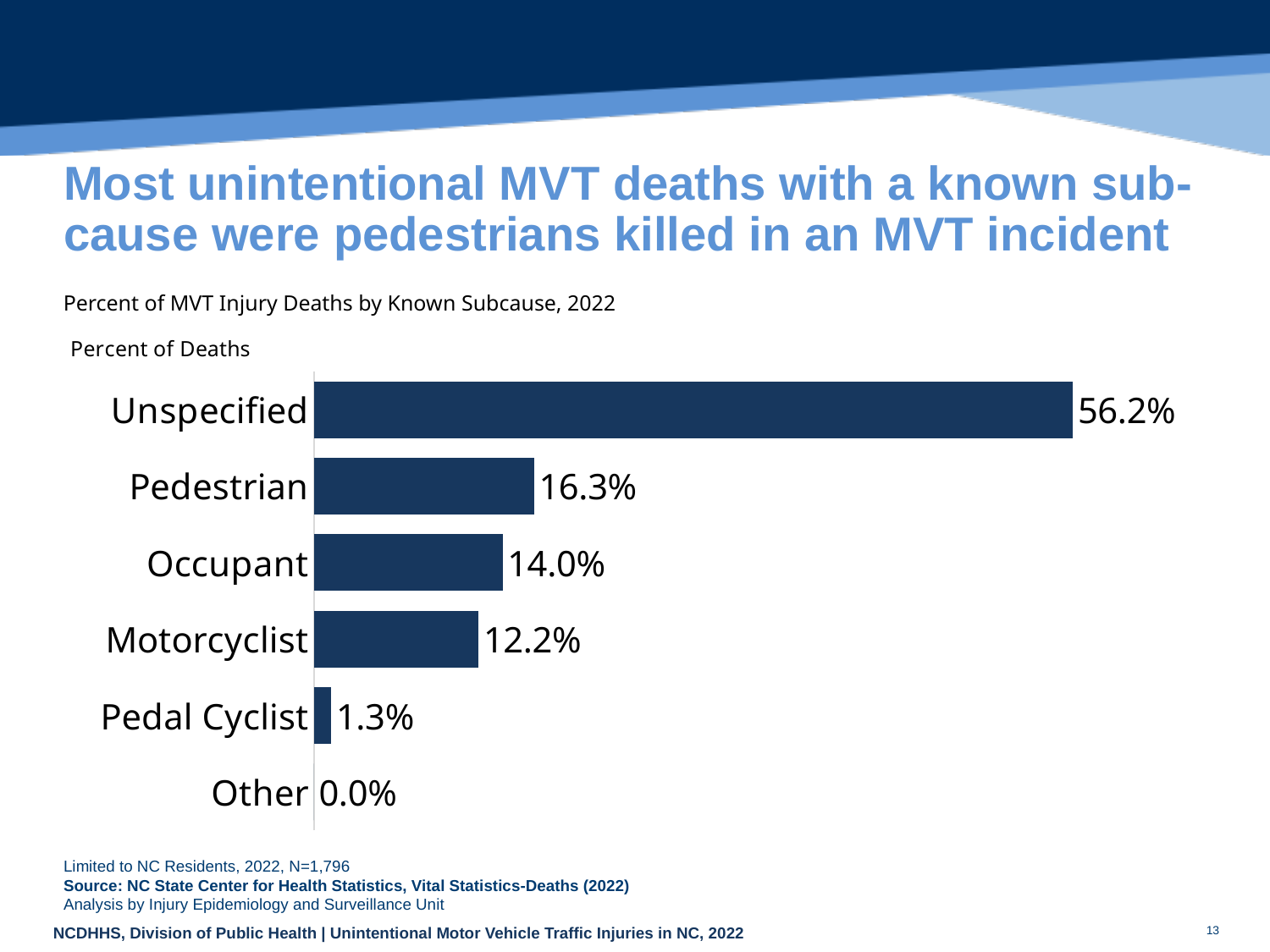
What is the value for Pedestrian? 16.3% Which category has the highest percent of deaths? Unspecified What kind of chart is shown on the slide? Bar chart Which category has the lowest percent of deaths? Other How many categories are shown in the chart? 6 Which is larger, the value for Occupant or the value for Motorcyclist? Occupant What percent of MVT injury deaths had an unspecified subcause? 56.2% What is the title of the chart? Percent of MVT Injury Deaths by Known Subcause, 2022 What is the difference between the Unspecified and Pedestrian values? 39.9% What is the difference between the Pedestrian and Occupant values? 2.3% What is the value for Motorcyclist? 12.2% What is the value for Pedal Cyclist? 1.3%